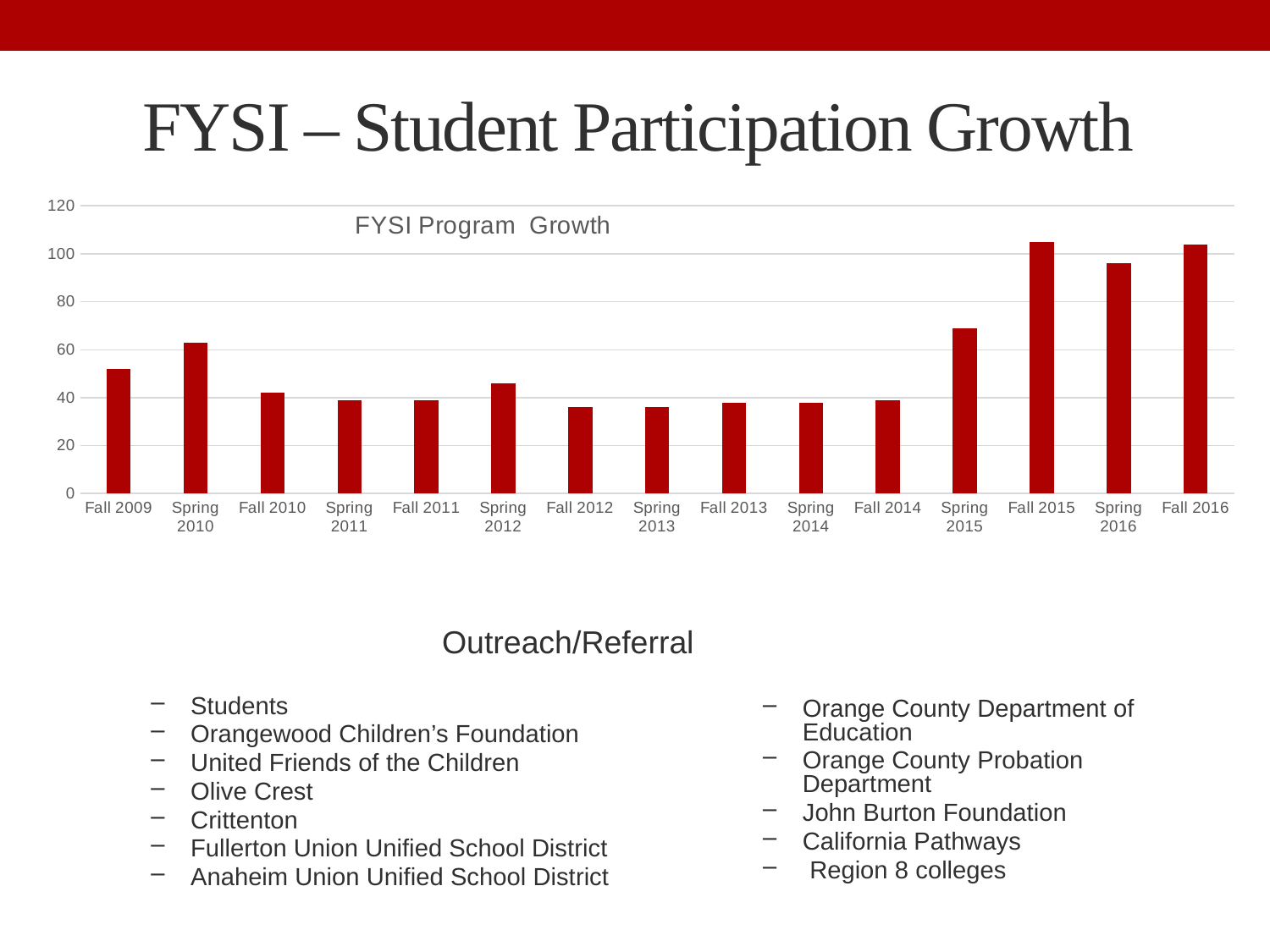
Which is larger, the value for Fall 2015 or the value for Spring 2016? Fall 2015 Is the value for Fall 2015 greater or less than 100? greater Is the value for Spring 2015 greater or less than 60? greater What kind of chart is shown on the slide? Bar chart Overall, do the values rise or fall from Fall 2009 to Fall 2016? Rise Is the value for Spring 2016 greater or less than 100? less What is the title printed inside the chart area? FYSI Program Growth How many terms (categories) are plotted along the x axis of the chart? 15 Which is larger, the value for Spring 2010 or the value for Fall 2010? Spring 2010 Which is larger, the value for Spring 2015 or the value for Fall 2014? Spring 2015